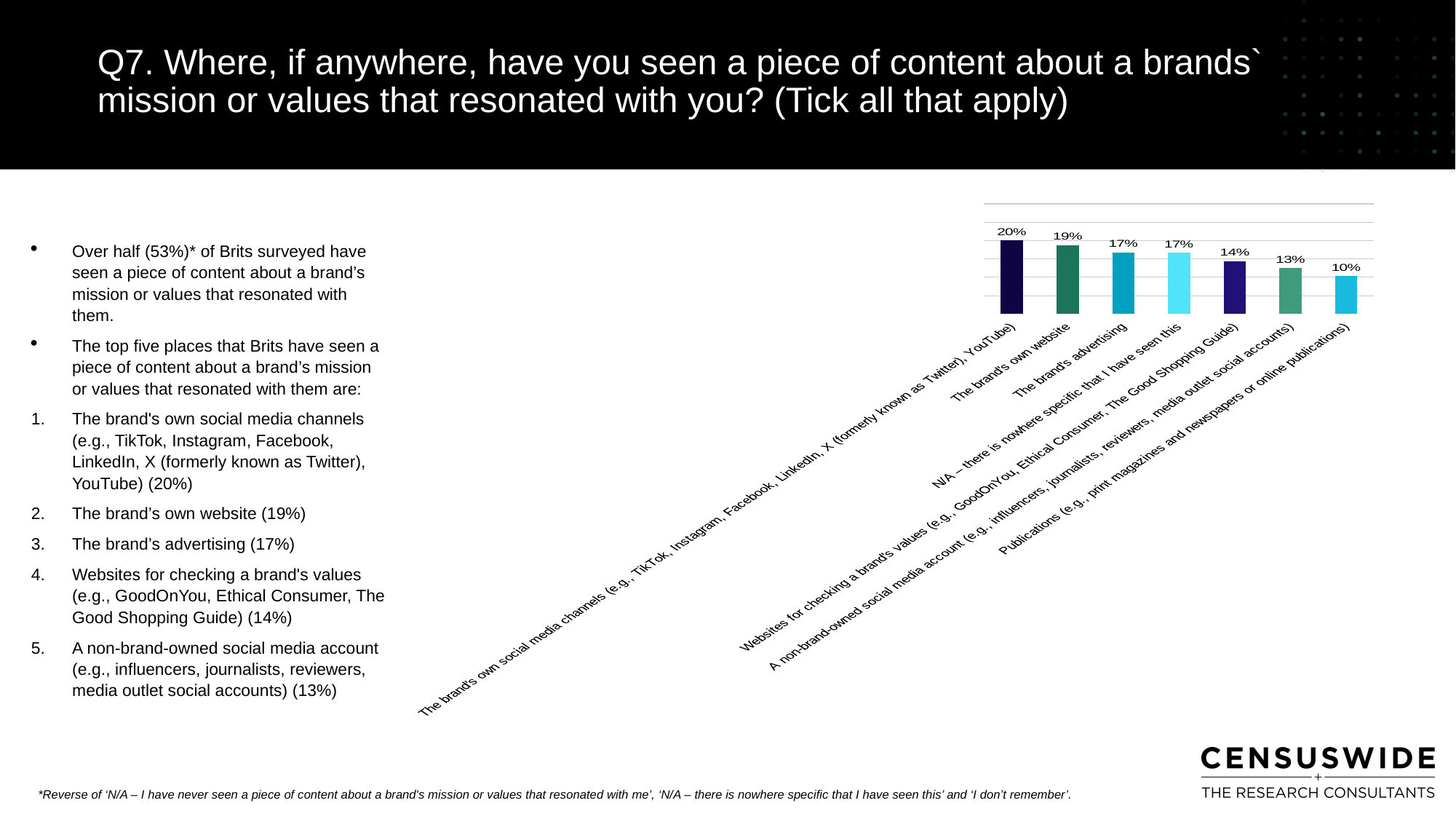
What is the value for 'The brand's advertising'? 17% What is the value for 'Publications (e.g., print magazines and newspapers or online publications)'? 10% Which category has the lowest value in the chart? Publications (e.g., print magazines and newspapers or online publications) What is the difference between the value for 'The brand's own social media channels' and the value for 'Publications'? 10% What is the value for 'The brand's own website'? 19% What is the value for 'N/A – there is nowhere specific that I have seen this'? 17% What kind of chart is shown on the slide? Bar chart How many bars does the chart show? 7 What is the difference between the value for 'The brand's own website' and the value for 'The brand's advertising'? 2% Which category has the highest value in the chart? The brand's own social media channels (e.g., TikTok, Instagram, Facebook, LinkedIn, X (formerly known as Twitter), YouTube) Which is larger: the value for 'Websites for checking a brand's values' or the value for 'A non-brand-owned social media account'? Websites for checking a brand's values Do the values generally rise or fall from left to right across the chart? Fall